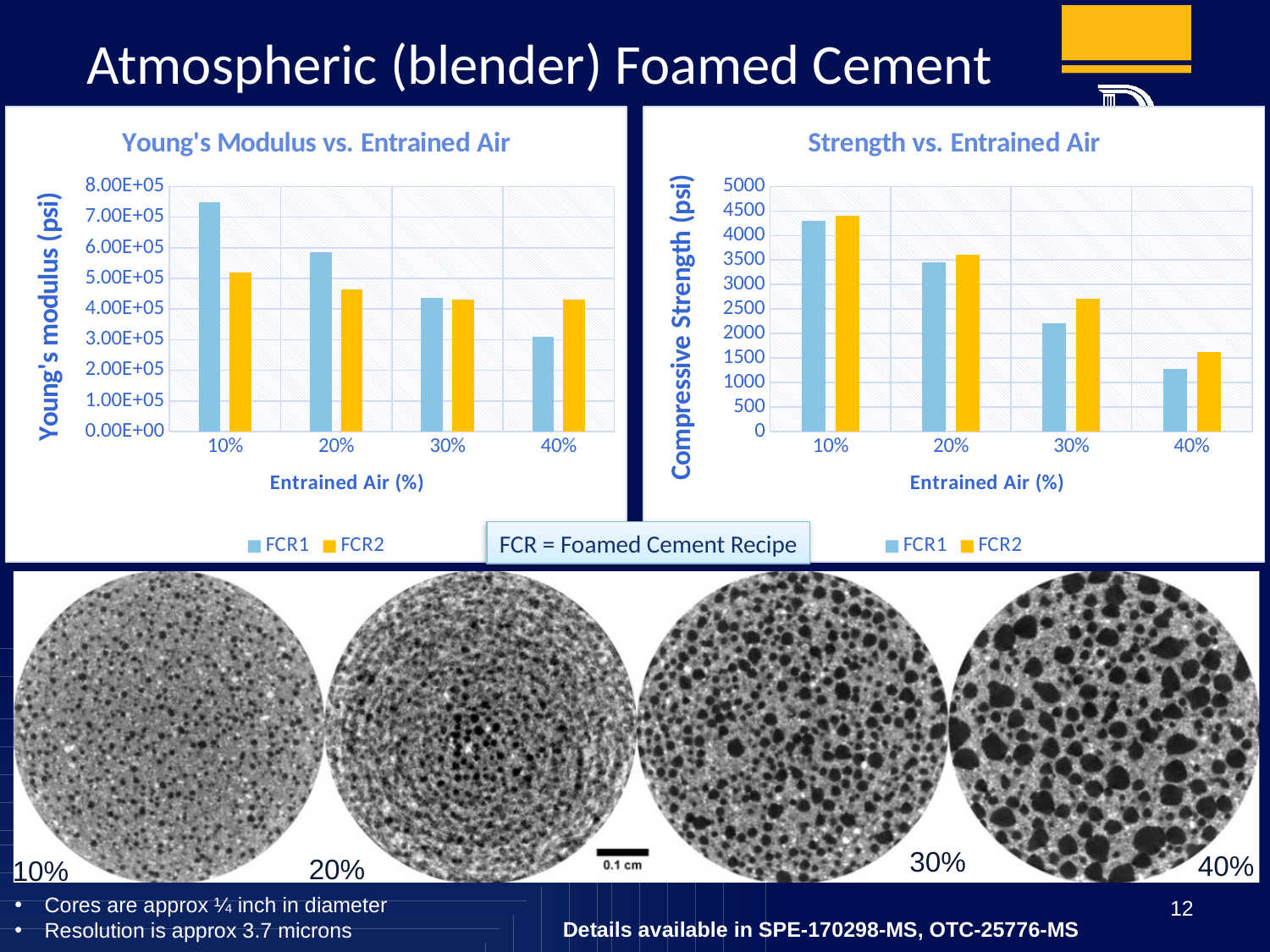
In the 'Young's Modulus vs. Entrained Air' chart, is the FCR1 value at 10% greater or less than 7.00E+05? greater In the 'Young's Modulus vs. Entrained Air' chart, at which entrained air level is the FCR1 value highest? 10% How many entrained air categories are shown on the x axis of the 'Young's Modulus vs. Entrained Air' chart? 4 In the 'Young's Modulus vs. Entrained Air' chart, which series has the larger value at 10% entrained air, FCR1 or FCR2? FCR1 What is the y-axis title of the 'Strength vs. Entrained Air' chart? Compressive Strength (psi) In the 'Strength vs. Entrained Air' chart, do the FCR1 values rise or fall as entrained air increases from 10% to 40%? fall What kind of chart is the 'Young's Modulus vs. Entrained Air' chart? bar chart In the 'Strength vs. Entrained Air' chart, is the FCR2 value at 30% greater or less than 2500? greater In the 'Strength vs. Entrained Air' chart, at which entrained air level is the FCR1 value lowest? 40% In the 'Strength vs. Entrained Air' chart, which series has the larger value at 30% entrained air, FCR1 or FCR2? FCR2 In the 'Strength vs. Entrained Air' chart, is the FCR1 value at 40% greater or less than 1500? less How many series does the legend of the 'Strength vs. Entrained Air' chart list? 2